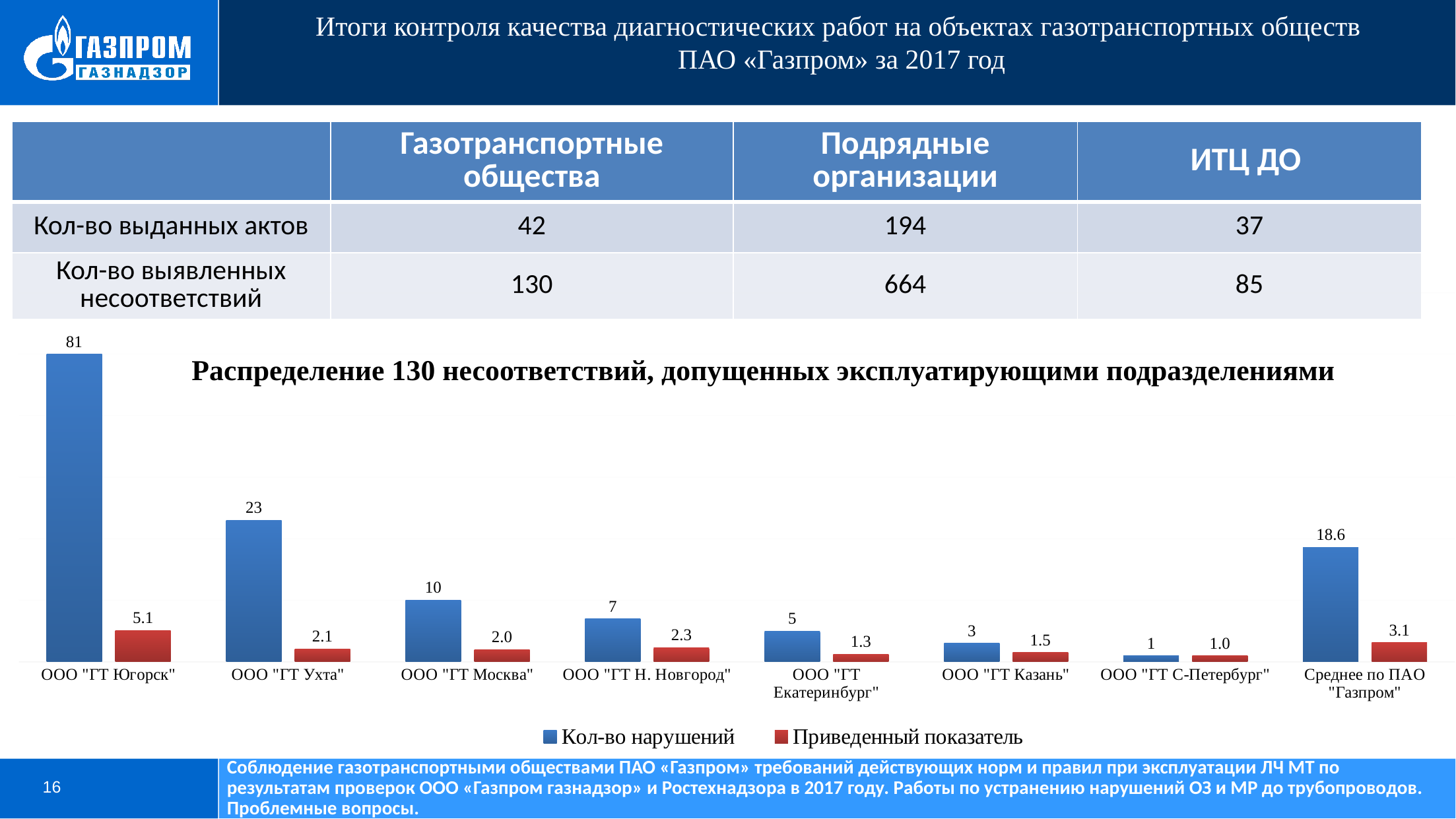
What is the value of "Приведенный показатель" for ООО "ГТ Н. Новгород"? 2.3 Which is larger: "Приведенный показатель" for ООО "ГТ Москва" or for ООО "ГТ Н. Новгород"? ООО "ГТ Н. Новгород" Which category has the lowest value of "Приведенный показатель"? ООО "ГТ С-Петербург" What type of chart is shown on the slide? bar chart What is the value of "Кол-во нарушений" for Среднее по ПАО "Газпром"? 18.6 How many categories are shown on the x axis of the chart? 8 Which category has the highest value of "Кол-во нарушений"? ООО "ГТ Югорск" What colour are the bars for the series "Приведенный показатель"? red What is the value of "Кол-во нарушений" for ООО "ГТ Югорск"? 81 What is the difference in "Кол-во нарушений" between ООО "ГТ Югорск" and ООО "ГТ Ухта"? 58 What is the title of the chart? Распределение 130 несоответствий, допущенных эксплуатирующими подразделениями How many series does the chart legend list? 2